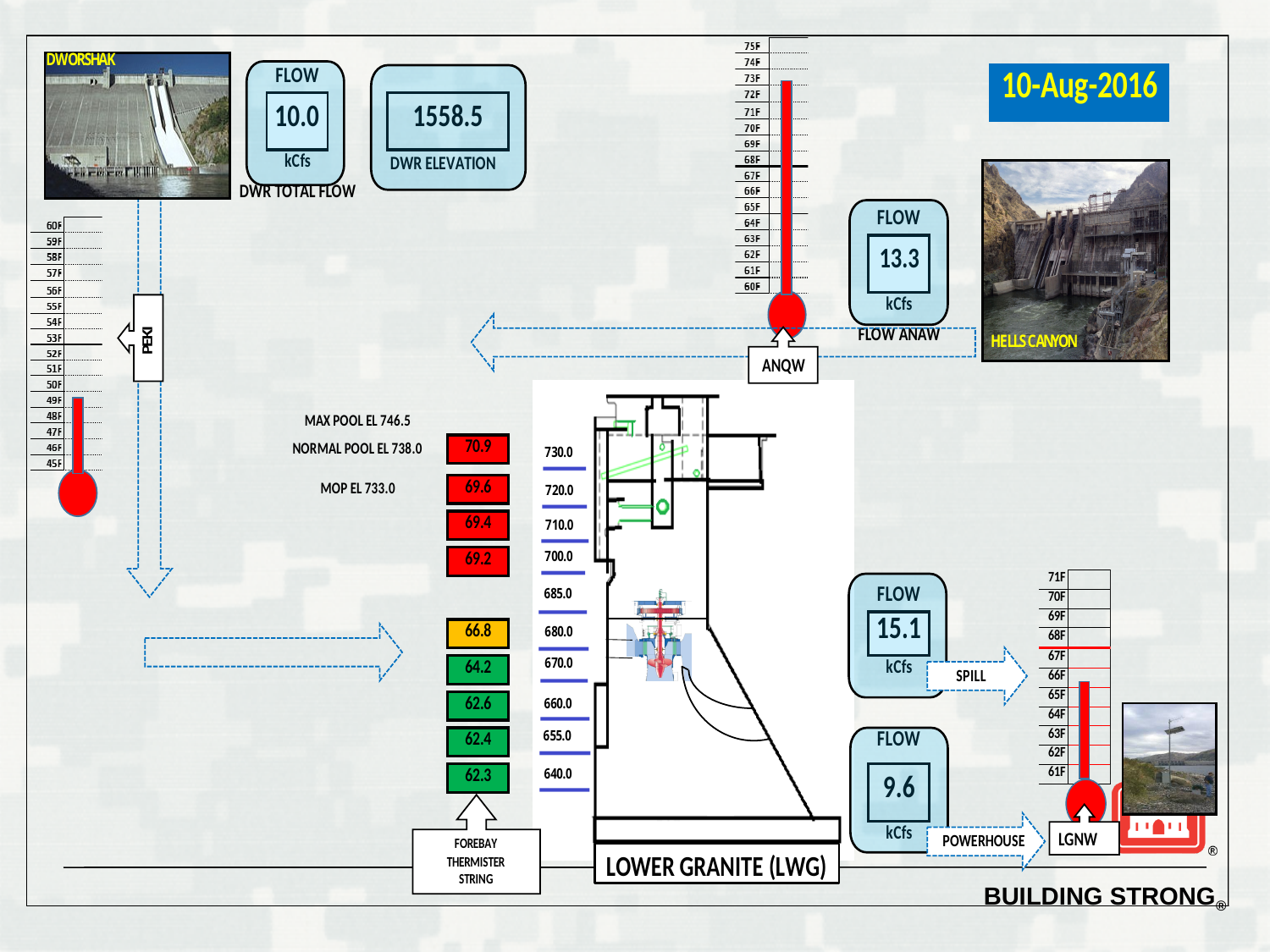
On the forebay thermistor string, what is the highest temperature value shown? 70.9 On the forebay thermistor string, what is the lowest temperature value shown? 62.3 How many temperature values are shown on the forebay thermistor string? 9 On the forebay thermistor string, which is larger: the value in the orange box (66.8) or the green box directly below it (64.2)? 66.8 On the PEKI thermometer on the left of the slide, is the reading greater or less than 55F? less What is the FLOW ANAW value shown in the flow gauge next to the Hells Canyon photo? 13.3 kCfs What date is shown on the slide? 10-Aug-2016 On the forebay thermistor string, what is the difference between the highest value (70.9) and the lowest value (62.3)? 8.6 What is the SPILL flow value shown for Lower Granite? 15.1 kCfs On the ANQW thermometer at the top of the slide, is the reading greater or less than 65F? greater On the LGNW thermometer at the lower right, is the reading greater or less than 63F? greater On the forebay thermistor string, do the temperature values rise or fall going from the top box down to the bottom box? fall